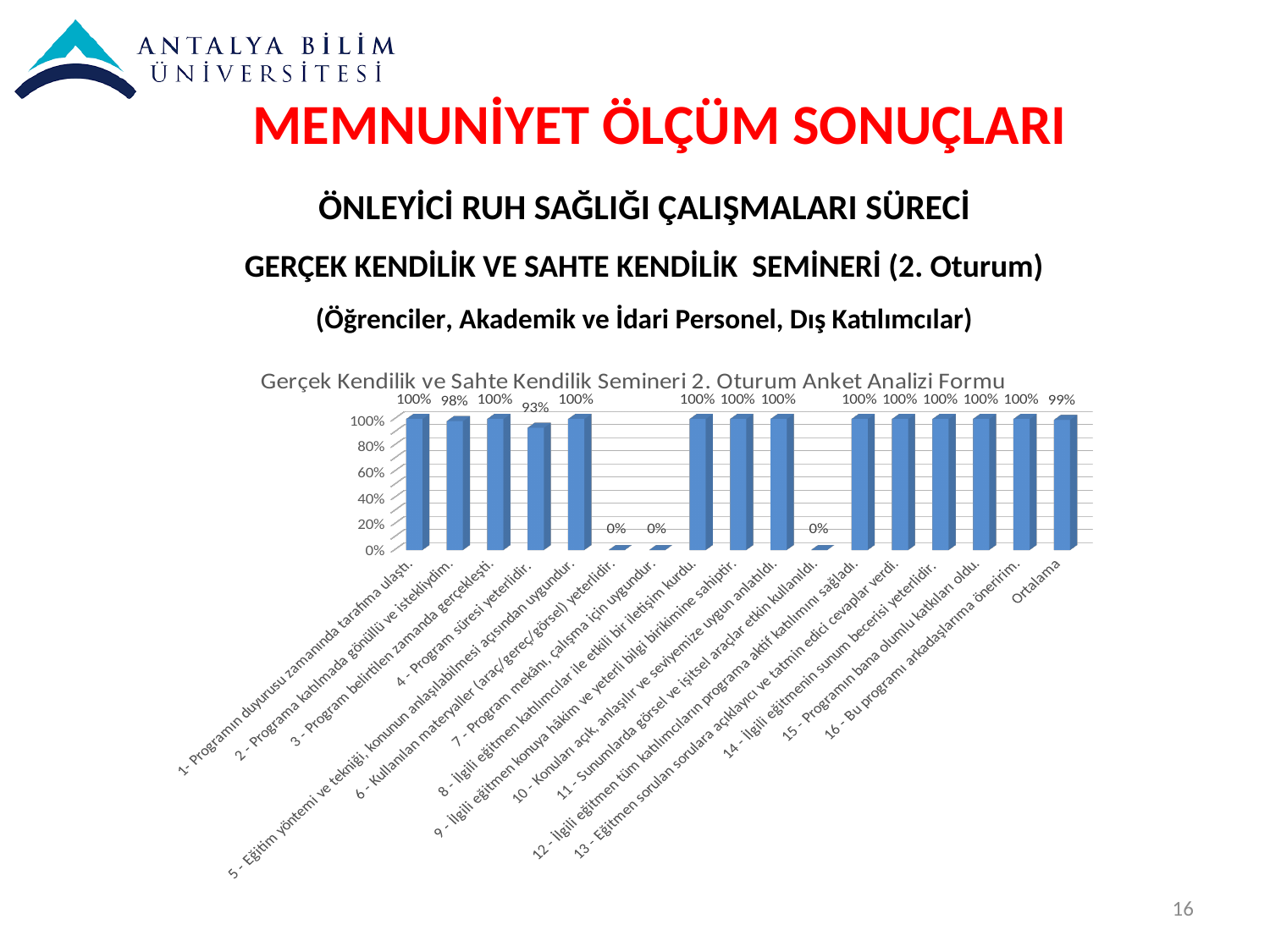
What is the value for "4- Program süresi yeterlidir."? 93% What is the value for "2- Programa katılmada gönüllü ve istekliydim."? 98% What is the value for "Ortalama"? 99% Is the value for "4- Program süresi yeterlidir." greater or less than 80%? greater How many categories are shown on the x axis of the chart? 17 What type of chart is shown on the slide? Bar chart What is the value for "16- Bu programı arkadaşlarıma öneririm."? 100% Which is larger, the value for "2- Programa katılmada gönüllü ve istekliydim." or the value for "4- Program süresi yeterlidir."? 2- Programa katılmada gönüllü ve istekliydim. What is the value for "6- Kullanılan materyaller (araç/gereç/görsel) yeterlidir."? 0% How many categories in the chart have a value of 0%? 3 What is the difference between the value for "1- Programın duyurusu zamanında tarafıma ulaştı." and the value for "4- Program süresi yeterlidir."? 7% What is the title of the chart? Gerçek Kendilik ve Sahte Kendilik Semineri 2. Oturum Anket Analizi Formu